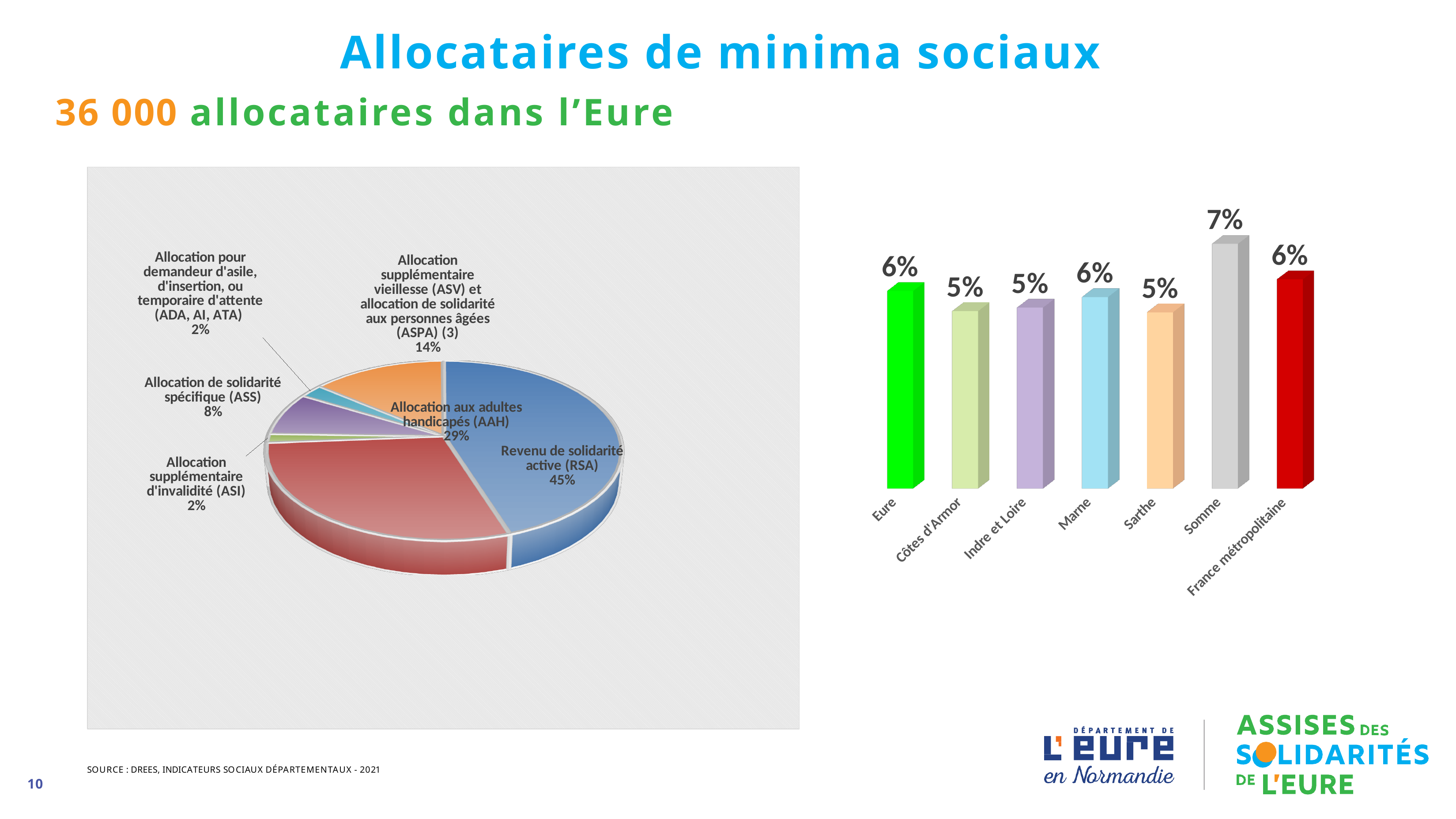
In the pie chart on the left, what share is Revenu de solidarité active (RSA)? 45% In the bar chart on the right, what is the value for Eure? 6% In the bar chart on the right, which category has the highest value? Somme In the pie chart on the left, how many slices are there? 6 In the pie chart on the left, which slice is the largest? Revenu de solidarité active (RSA) In the bar chart on the right, how many categories are shown? 7 In the bar chart on the right, what is the difference between Somme and Sarthe? 2% In the pie chart on the left, what share is Allocation aux adultes handicapés (AAH)? 29% In the pie chart on the left, what is the difference between the RSA share and the AAH share? 16% What kind of chart is on the right of the slide? Bar chart In the pie chart on the left, what share is Allocation de solidarité spécifique (ASS)? 8% In the bar chart on the right, what is the value for Somme? 7%